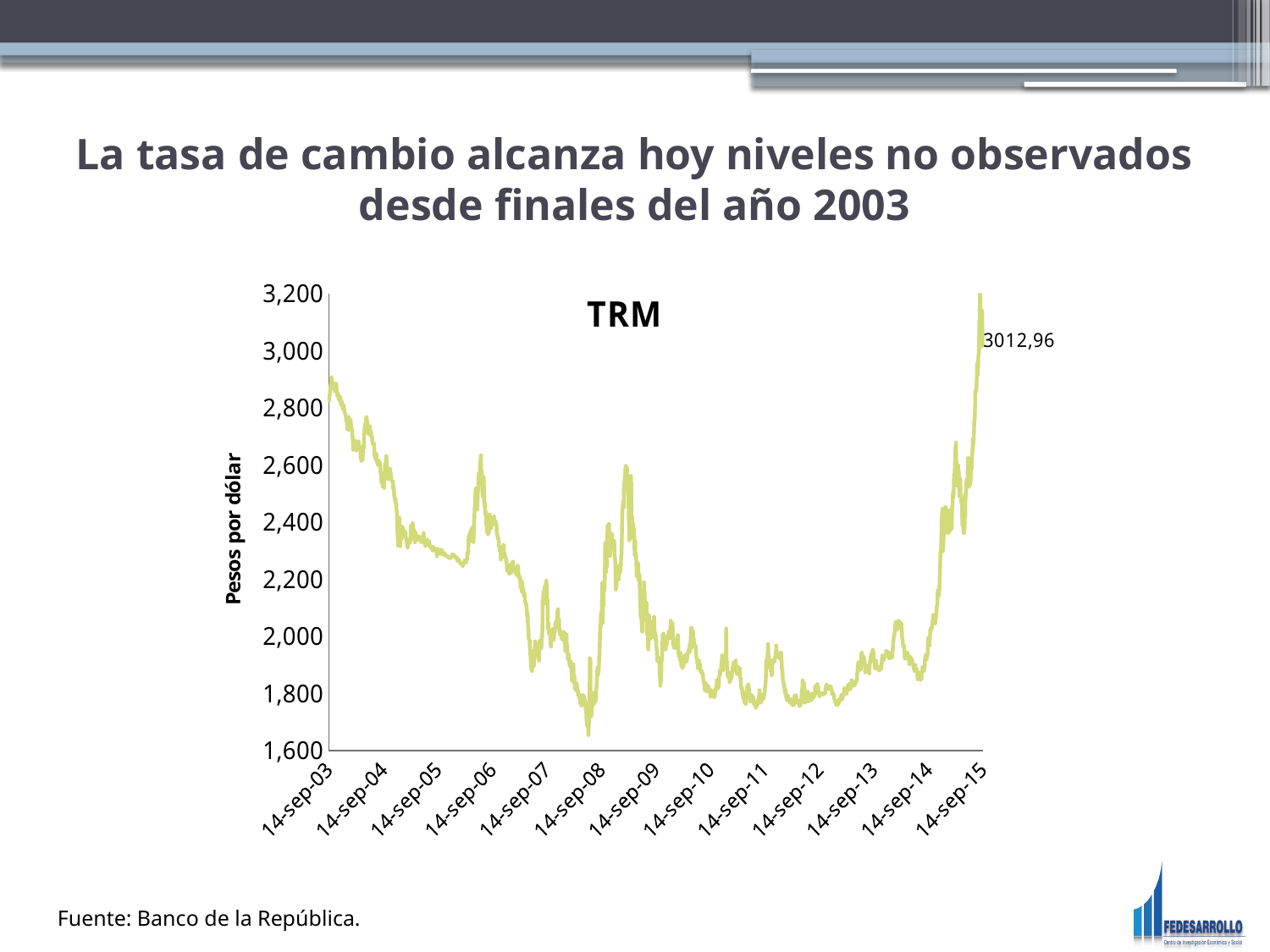
Is the value at 14-sep-05 greater or less than 2,000? greater How many date labels are shown on the x axis? 13 Is the value at 14-sep-12 greater or less than 2,000? less Which is larger, the value at 14-sep-03 or the value at 14-sep-12? 14-sep-03 What kind of chart is shown on the slide? line chart What is the title of the chart? TRM Is the value at 14-sep-03 greater or less than 2,800? greater What value is printed as the data label at the end of the line? 3012,96 What is the label of the vertical axis? Pesos por dólar Does the line rise or fall between 14-sep-14 and 14-sep-15? rise Does the line overall rise or fall between 14-sep-03 and 14-sep-08? fall